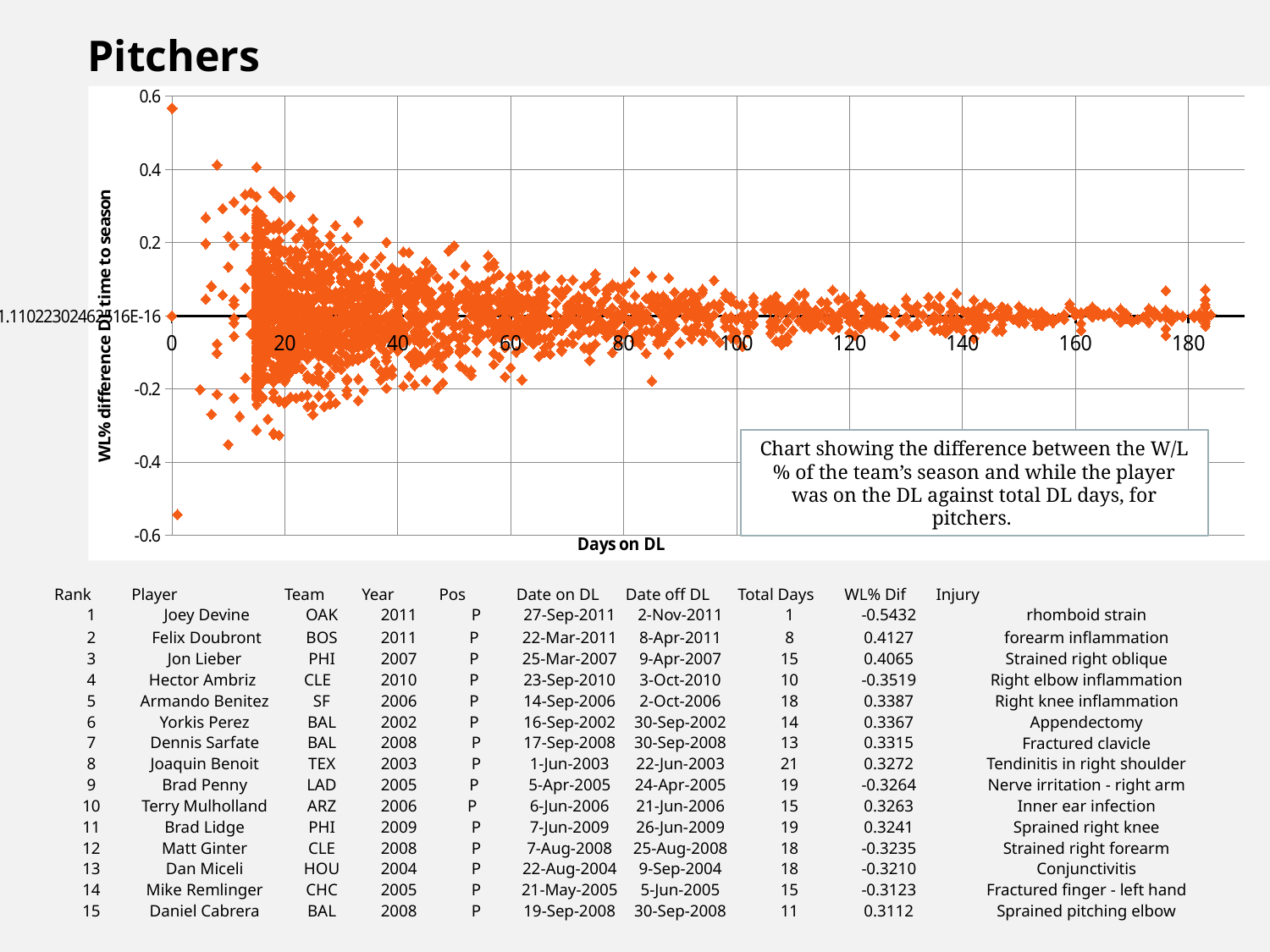
What is the title of the x axis of the chart? Days on DL What kind of chart is shown on the slide? scatter chart Is the lowest plotted point on the chart greater or less than -0.4 on the y axis? less What is the title of the y axis of the chart? WL% difference DL time to season As the number of days on DL increases along the x axis, does the vertical spread of the points widen or narrow? narrow Is the highest plotted point on the chart greater or less than 0.4 on the y axis? greater How many data series are plotted on the chart? 1